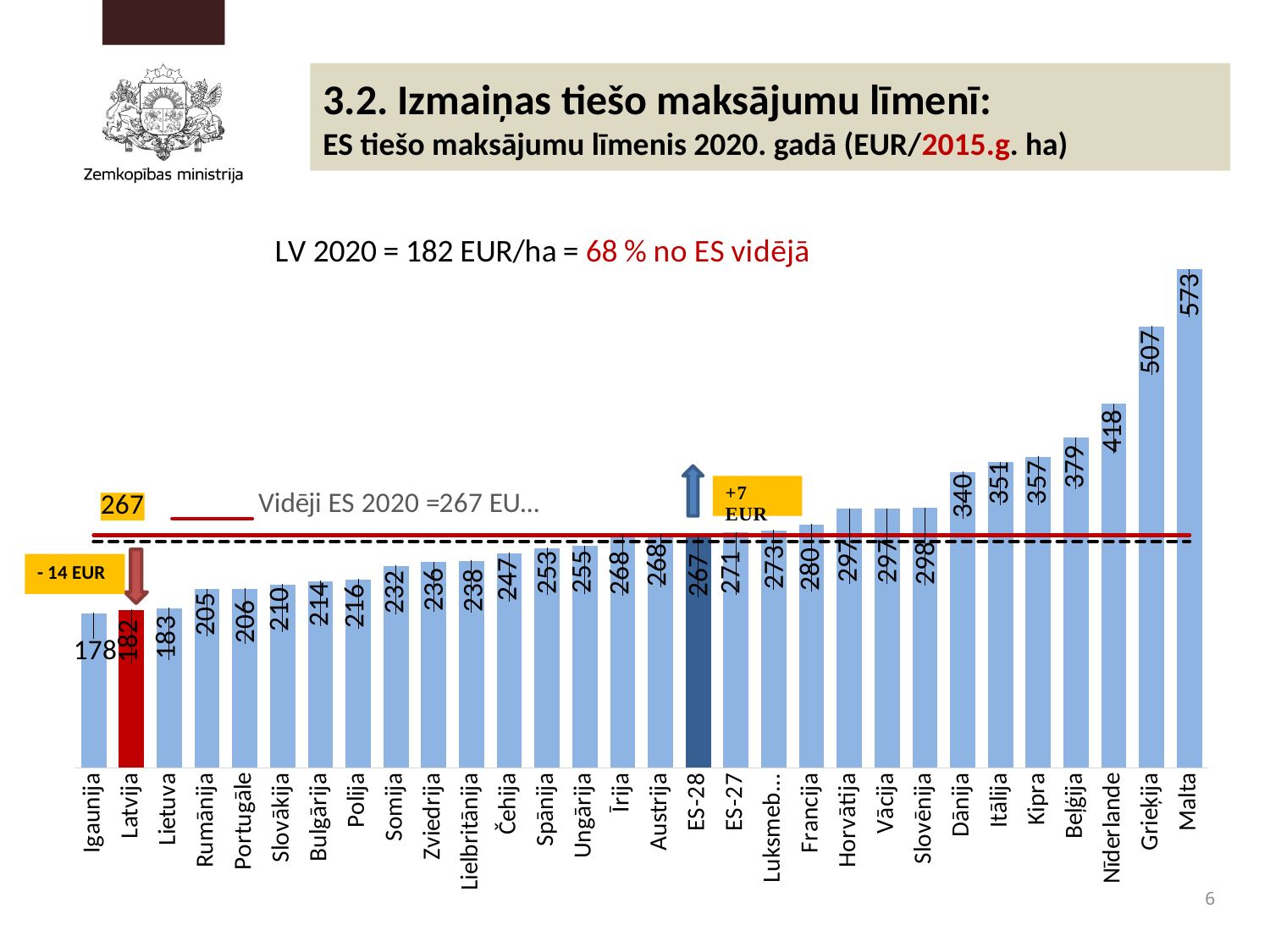
What is the difference between the values for ES-28 and Latvija? 85 Which category's bar is coloured red? Latvija How many categories are shown on the x axis? 30 Which category has the highest value? Malta Which is larger, the value for Francija or the value for Polija? Francija What is the value for Malta? 573 What is the value for Latvija? 182 What kind of chart is shown on the slide? bar chart What is the value for ES-28? 267 What is the difference between the values for Malta and Grieķija? 66 What is the value for Dānija? 340 Which category has the lowest value? Igaunija